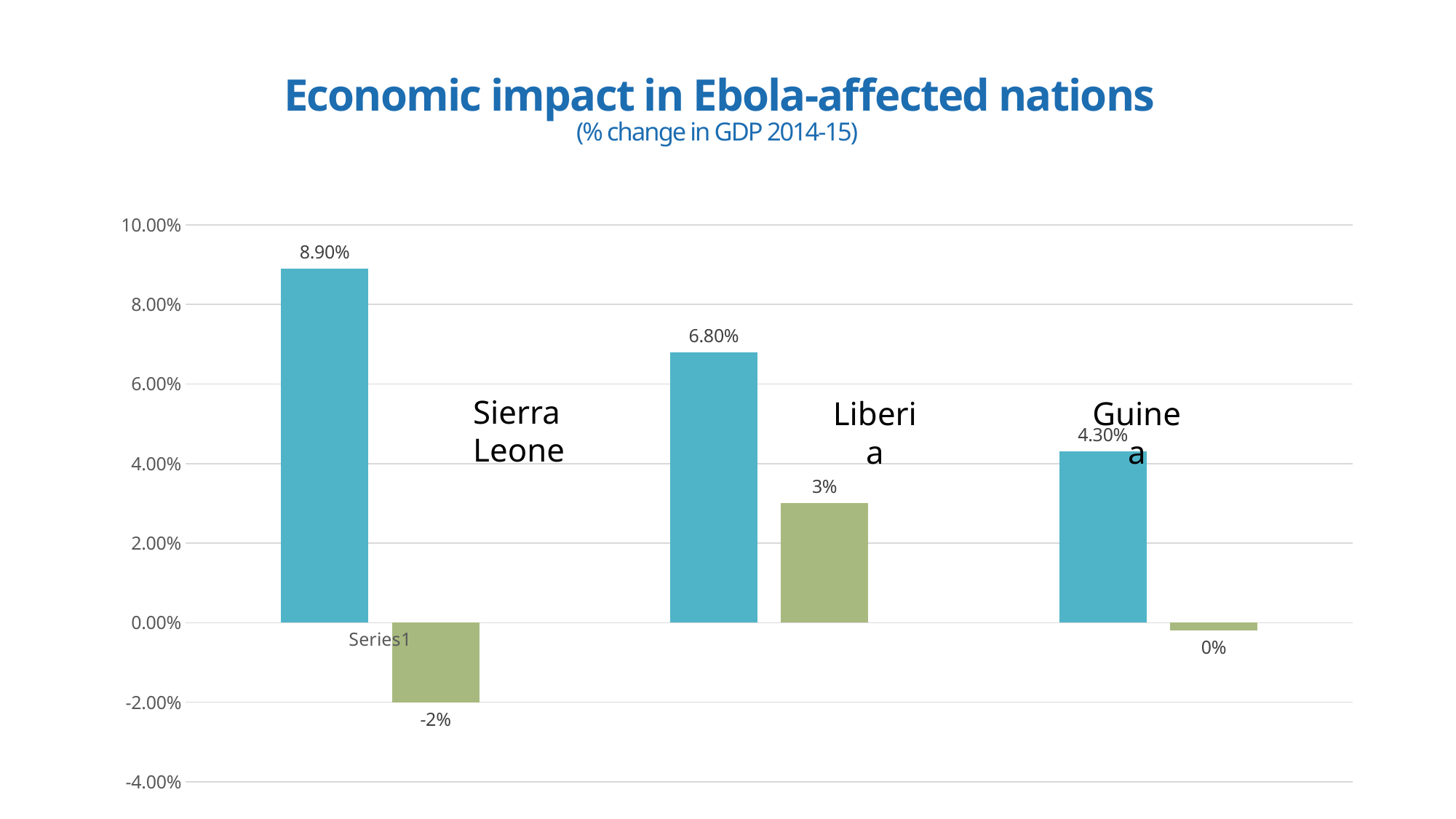
What is the value of the green bar for Guinea? 0% What is the value of the blue bar for Guinea? 4.30% What is the difference between the blue bar values for Sierra Leone and Liberia? 2.10% Which country has the highest blue bar? Sierra Leone What is the value of the blue bar for Sierra Leone? 8.90% What kind of chart is shown on the slide? Bar chart What is the value of the green bar for Sierra Leone? -2% Which country has the lowest green bar? Sierra Leone How many countries are shown on the chart? 3 Which is larger, the blue bar for Liberia or the blue bar for Guinea? Liberia What is the value of the green bar for Liberia? 3% Do the blue bars rise or fall from left to right across the countries? Fall